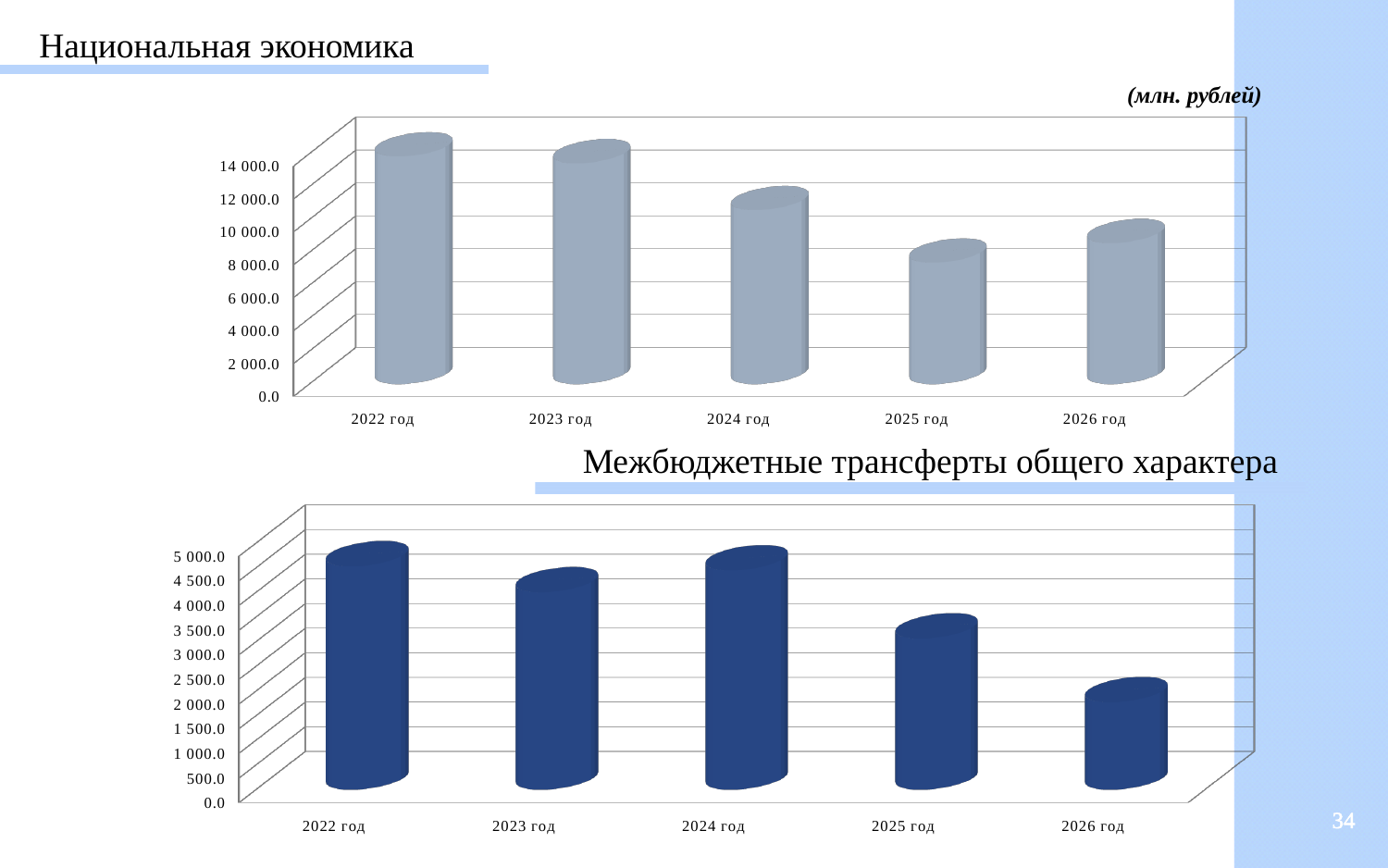
In the top chart "Национальная экономика", which is larger, the value for 2024 год or 2026 год? 2024 год What kind of chart is the top chart titled "Национальная экономика"? bar chart In the top chart "Национальная экономика", which year has the highest value? 2022 год How many years are shown on the x axis of the top chart "Национальная экономика"? 5 In the bottom chart "Межбюджетные трансферты общего характера", which is larger, the value for 2023 год or 2025 год? 2023 год In the top chart "Национальная экономика", is the value for 2022 год greater or less than 12 000.0? greater In the bottom chart "Межбюджетные трансферты общего характера", which year has the lowest value? 2026 год In the bottom chart "Межбюджетные трансферты общего характера", do the values rise or fall from 2024 год to 2026 год? fall In the bottom chart "Межбюджетные трансферты общего характера", is the value for 2026 год greater or less than 3 000.0? less In the top chart "Национальная экономика", which year has the lowest value? 2025 год What unit is stated for the values in the top chart "Национальная экономика"? млн. рублей In the top chart "Национальная экономика", is the value for 2025 год greater or less than 10 000.0? less